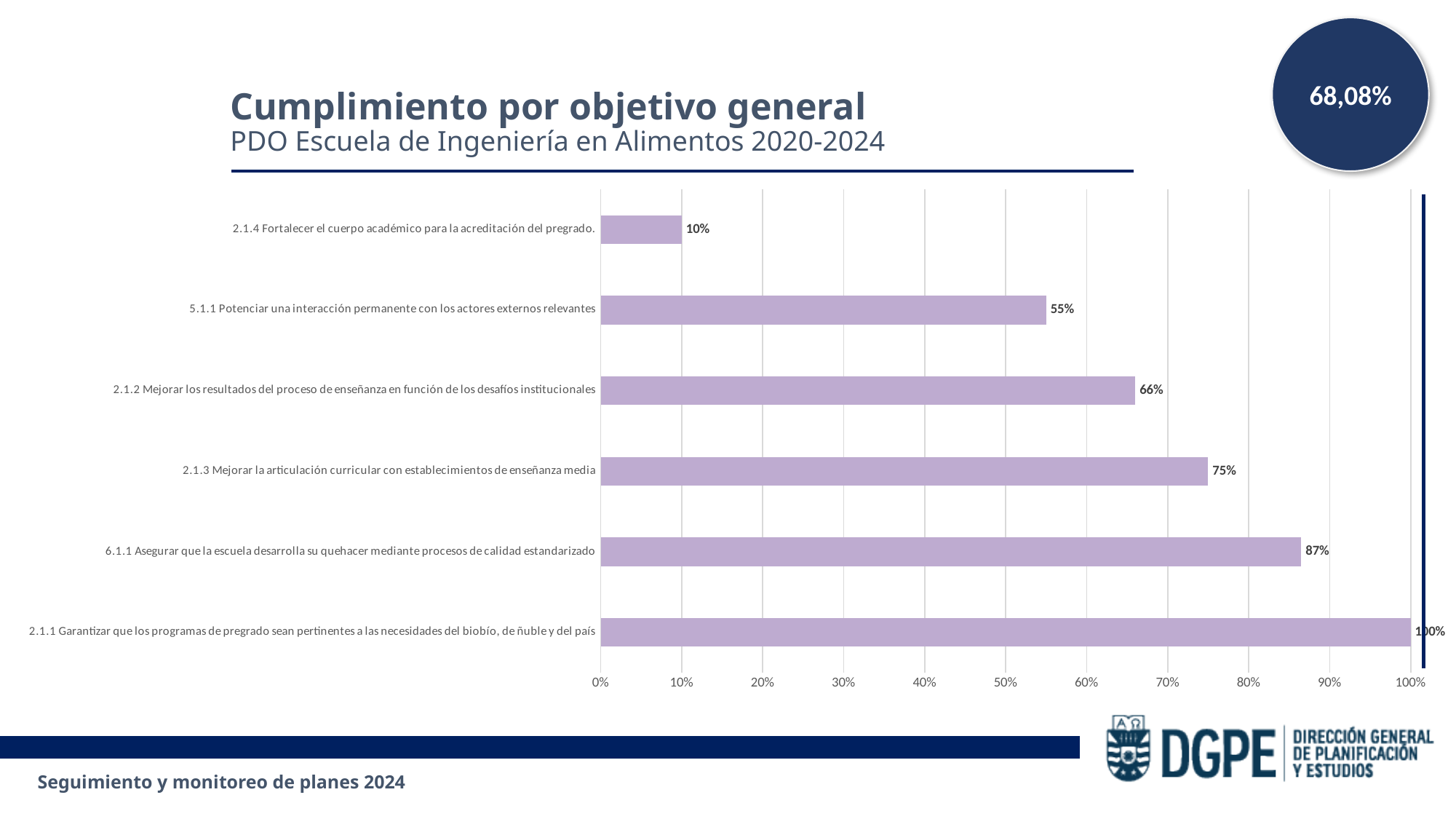
What is the difference between the values for objective 2.1.3 and objective 2.1.2? 9% Which objective has the highest value? 2.1.1 Garantizar que los programas de pregrado sean pertinentes a las necesidades del biobío, de ñuble y del país What kind of chart is shown on the slide? bar chart Which has a larger value, objective 5.1.1 or objective 2.1.2? 2.1.2 How many objectives are shown in the chart? 6 What is the value for objective 2.1.4 Fortalecer el cuerpo académico para la acreditación del pregrado? 10% Is the value for objective 2.1.3 greater or less than 70%? greater Which objective has the lowest value? 2.1.4 Fortalecer el cuerpo académico para la acreditación del pregrado. What is the value for objective 6.1.1 Asegurar que la escuela desarrolla su quehacer mediante procesos de calidad estandarizado? 87% What is the value for objective 5.1.1 Potenciar una interacción permanente con los actores externos relevantes? 55% What overall percentage is shown in the circle at the top right of the slide? 68,08% What is the difference between the values for objective 2.1.1 and objective 6.1.1? 13%